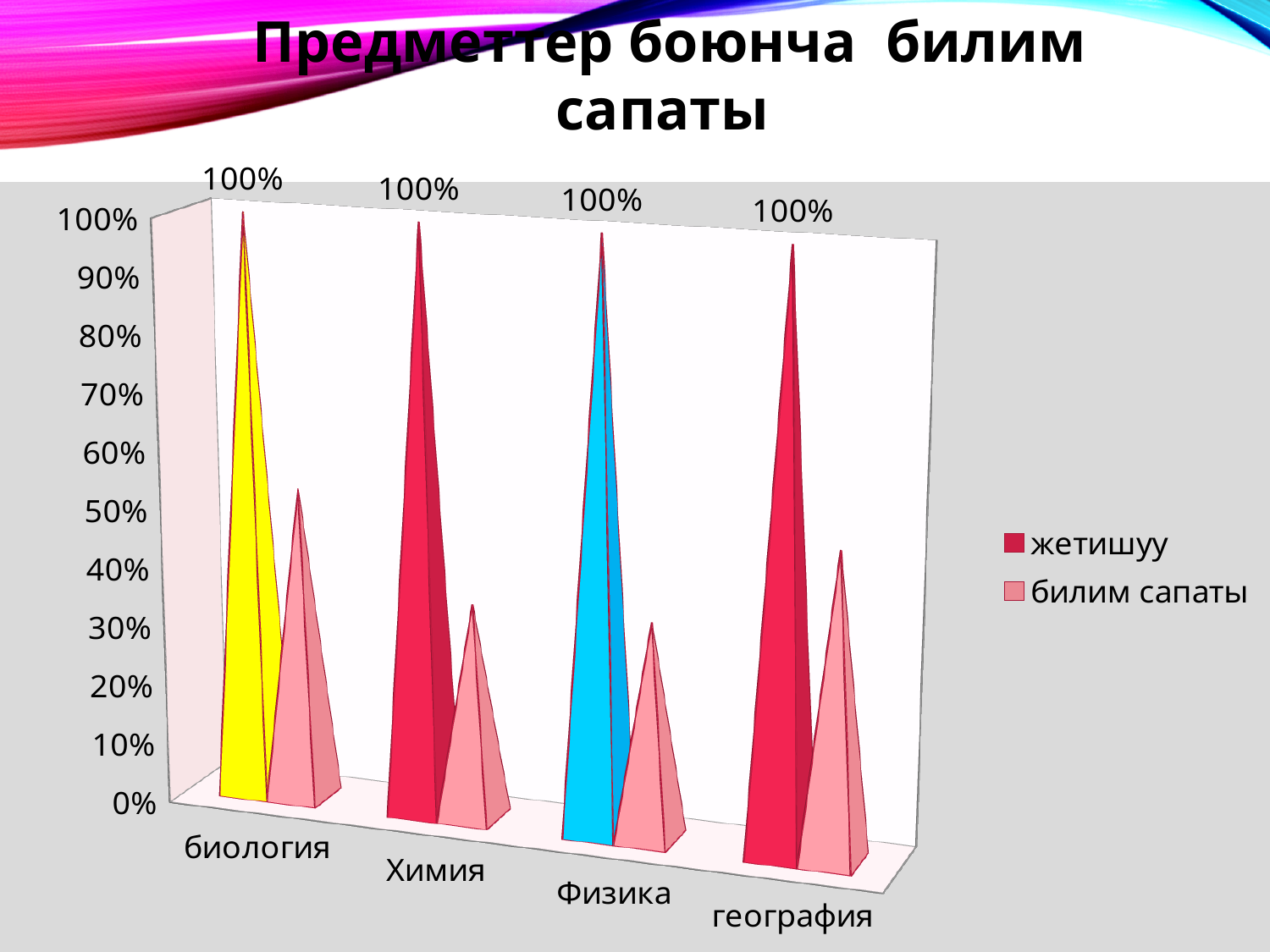
How many categories are shown on the x axis? 4 Which category has the larger билим сапаты value: биология or Химия? биология Which is larger for Химия: жетишуу or билим сапаты? жетишуу What is the value of жетишуу for Физика? 100% Is the value of билим сапаты for Химия greater or less than 50%? less How many series does the legend list? 2 What kind of chart is shown on the slide? bar chart What is the value of жетишуу for география? 100% Is the value of билим сапаты for география greater or less than 70%? less What is the value of жетишуу for биология? 100% What are the two entries listed in the legend? жетишуу and билим сапаты Is the value of билим сапаты for биология greater or less than 30%? greater